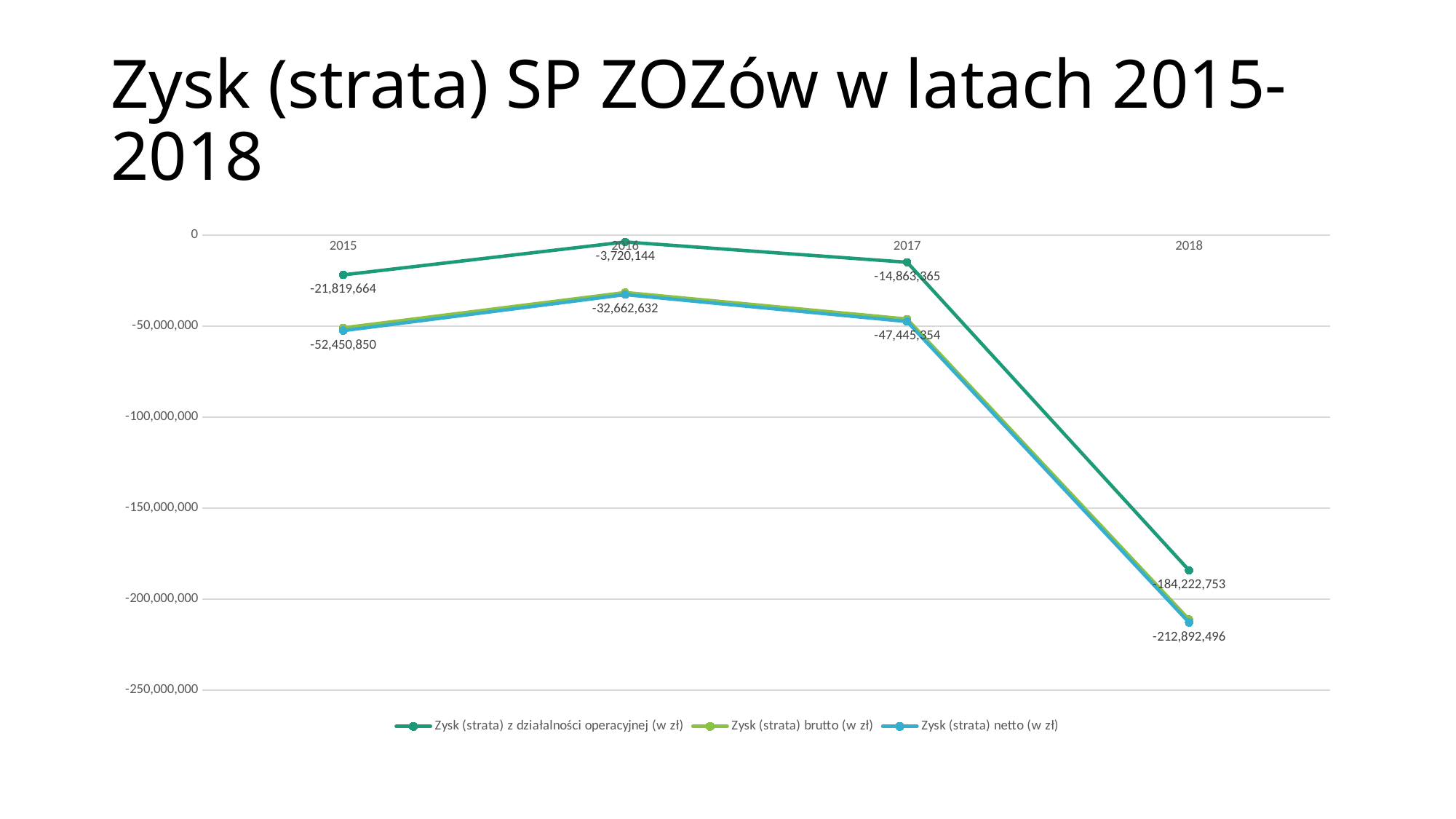
What is the value of Zysk (strata) z działalności operacyjnej (w zł) in 2016? -3,720,144 What is the value of Zysk (strata) z działalności operacyjnej (w zł) in 2015? -21,819,664 How many years are plotted on the x axis? 4 What is the difference between the Zysk (strata) z działalności operacyjnej (w zł) values for 2017 and 2018? 169,359,388 What is the value of Zysk (strata) z działalności operacyjnej (w zł) in 2018? -184,222,753 In which year is Zysk (strata) z działalności operacyjnej (w zł) highest? 2016 Is the value for Zysk (strata) netto (w zł) in 2018 greater or less than -200,000,000? less In which year is Zysk (strata) z działalności operacyjnej (w zł) lowest? 2018 How many series does the legend list? 3 What type of chart is shown on the slide? line chart Which series is drawn in blue in the legend? Zysk (strata) netto (w zł) What is the value of Zysk (strata) z działalności operacyjnej (w zł) in 2017? -14,863,365